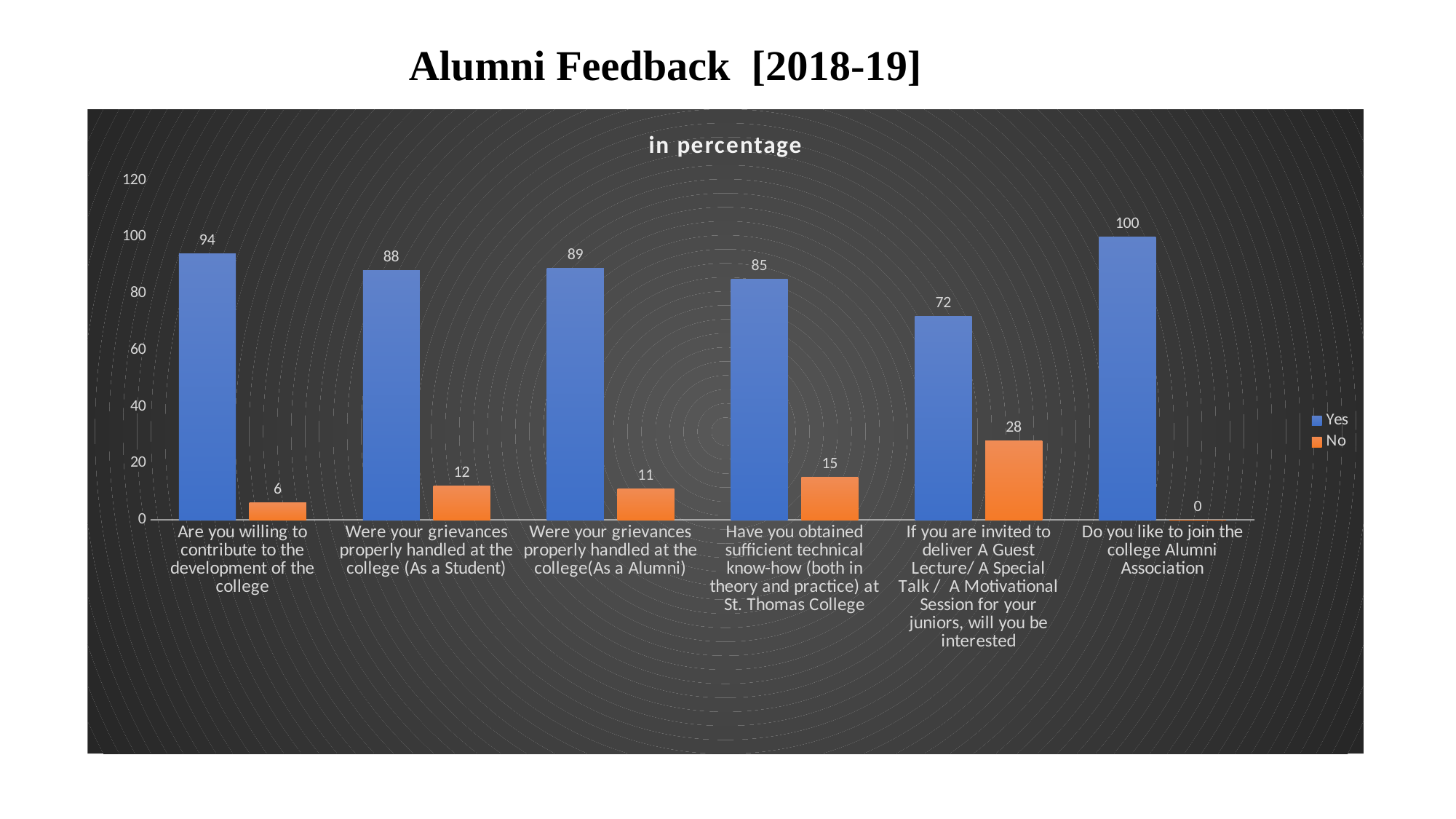
What is the No value for "If you are invited to deliver A Guest Lecture/ A Special Talk / A Motivational Session for your juniors, will you be interested"? 28 How many series does the legend list? 2 What kind of chart is shown on the slide? Bar chart What is the title shown inside the chart area? in percentage What is the Yes value for "Do you like to join the college Alumni Association"? 100 Which question has the lowest Yes value? If you are invited to deliver A Guest Lecture/ A Special Talk / A Motivational Session for your juniors, will you be interested Which is larger: the No value for "Were your grievances properly handled at the college(As a Alumni)" or the No value for "Have you obtained sufficient technical know-how (both in theory and practice) at St. Thomas College"? Have you obtained sufficient technical know-how (both in theory and practice) at St. Thomas College What is the Yes value for "Are you willing to contribute to the development of the college"? 94 How many questions (categories) are shown on the x axis? 6 What is the No value for "Have you obtained sufficient technical know-how (both in theory and practice) at St. Thomas College"? 15 Which question has the highest Yes value? Do you like to join the college Alumni Association What is the difference between the Yes and No values for "Were your grievances properly handled at the college (As a Student)"? 76